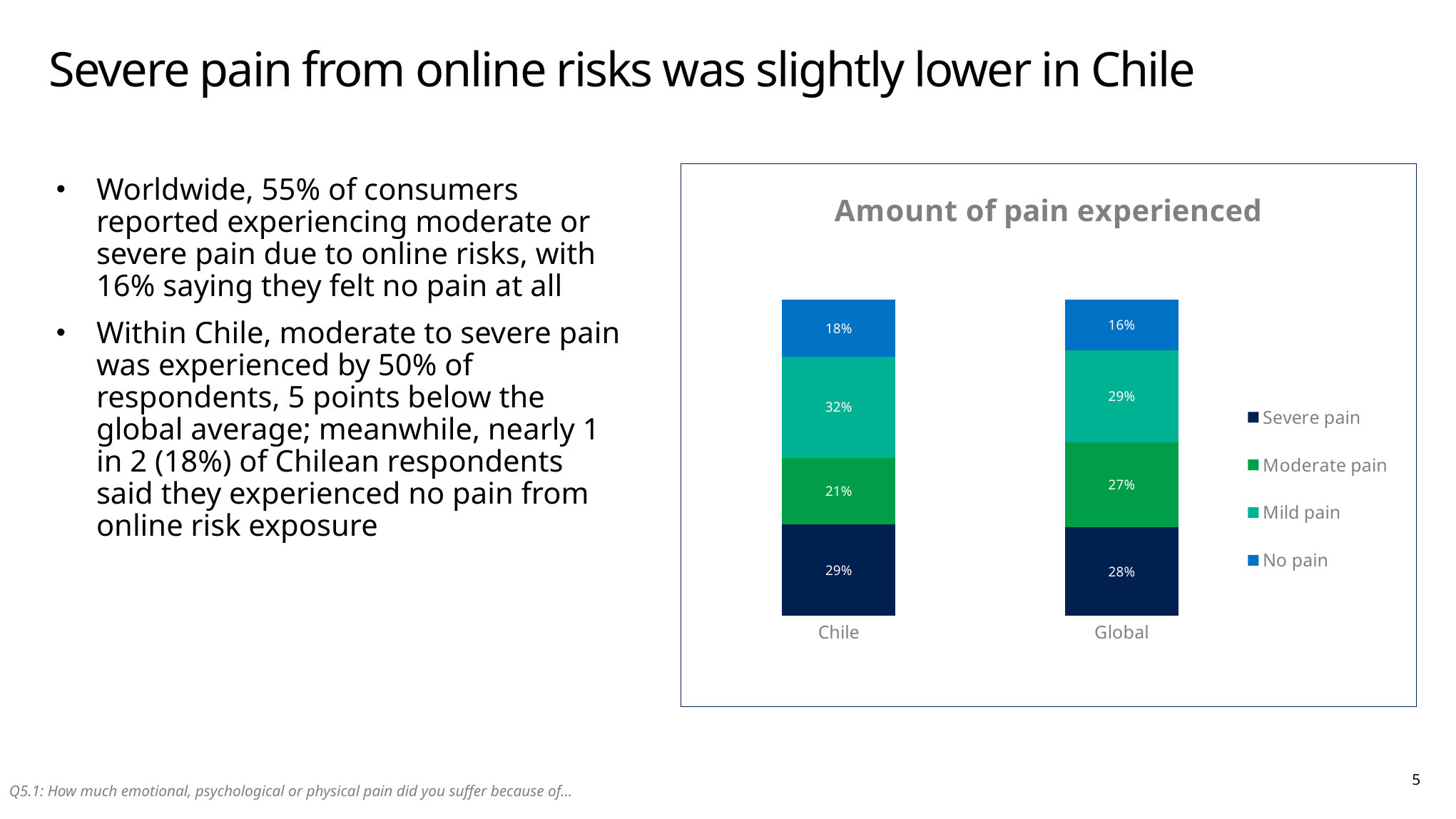
Which category has the higher Moderate pain value, Chile or Global? Global What kind of chart is shown? Stacked bar chart Which series has the smallest value in the Global bar? No pain How many categories are shown on the x axis? 2 What is the difference between the No pain values for Chile and Global? 2% What is the value for Moderate pain in the Global bar? 27% What percentage of Chile respondents reported severe pain? 29% What is the difference between the Mild pain values for Chile and Global? 3% Which series has the largest value in the Chile bar? Mild pain What percentage of Chile respondents reported no pain? 18% What is the value for Mild pain in the Global bar? 29% How many series does the legend list? 4